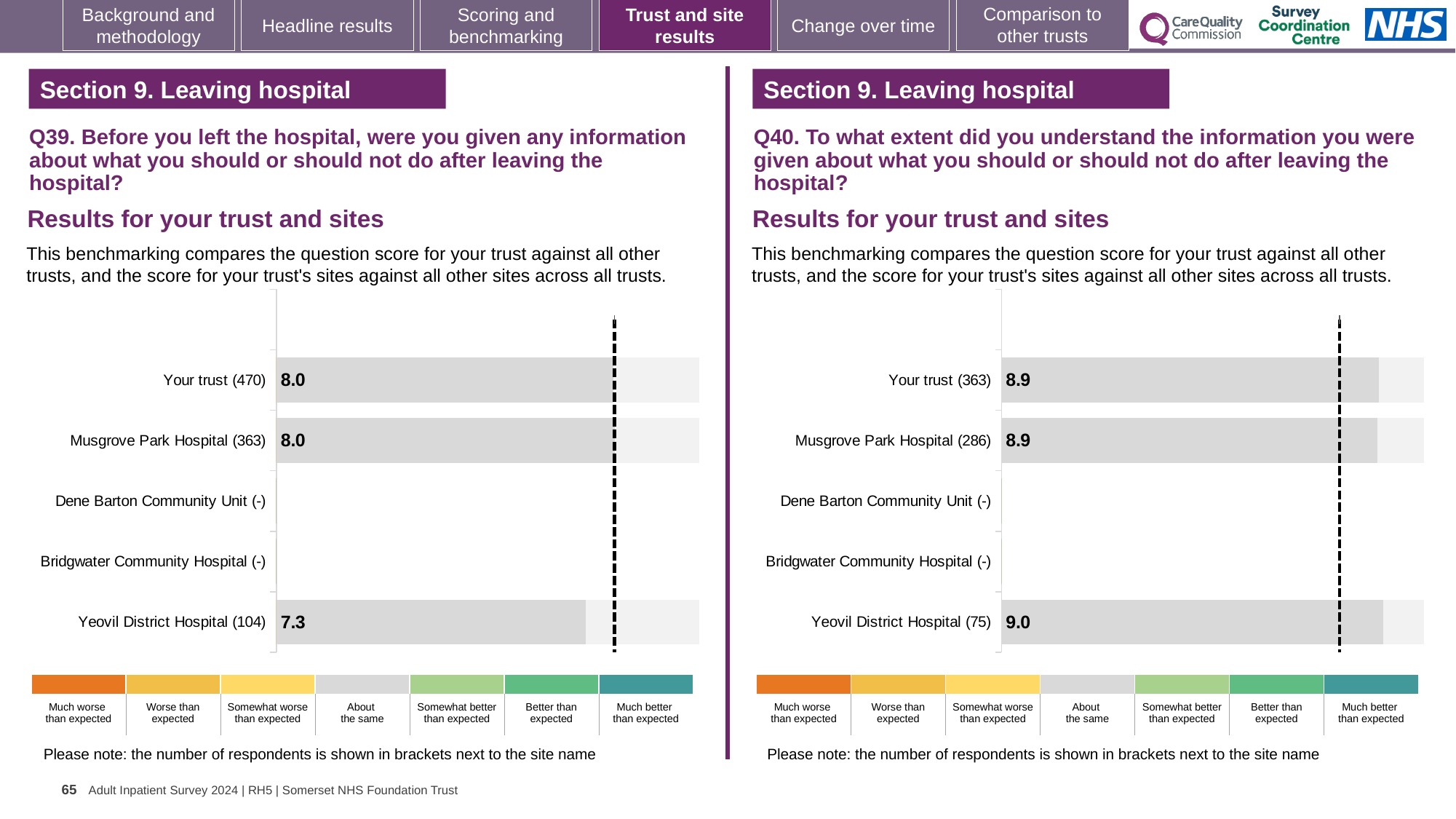
In the Q40 chart on the right, which site has the highest score? Yeovil District Hospital What kind of chart is the Q39 chart on the left? Bar chart In the Q39 chart on the left, what is the difference between the score for Musgrove Park Hospital and the score for Yeovil District Hospital? 0.7 How many rows (trust and sites) are listed in the Q40 chart on the right? 5 In the Q39 chart on the left, how many respondents are shown in brackets for Musgrove Park Hospital? 363 In the Q40 chart on the right, what is the difference between the score for Yeovil District Hospital and the score for Your trust? 0.1 In the Q39 chart on the left, which has the larger score: Your trust or Yeovil District Hospital? Your trust In the Q40 chart on the right, what is the score for Yeovil District Hospital (75)? 9.0 In the Q39 chart on the left, what is the score for Your trust (470)? 8.0 In the Q40 chart on the right, what is the score for Musgrove Park Hospital (286)? 8.9 In the Q39 chart on the left, which site has the lowest score? Yeovil District Hospital In the Q39 chart on the left, what is the score for Yeovil District Hospital (104)? 7.3